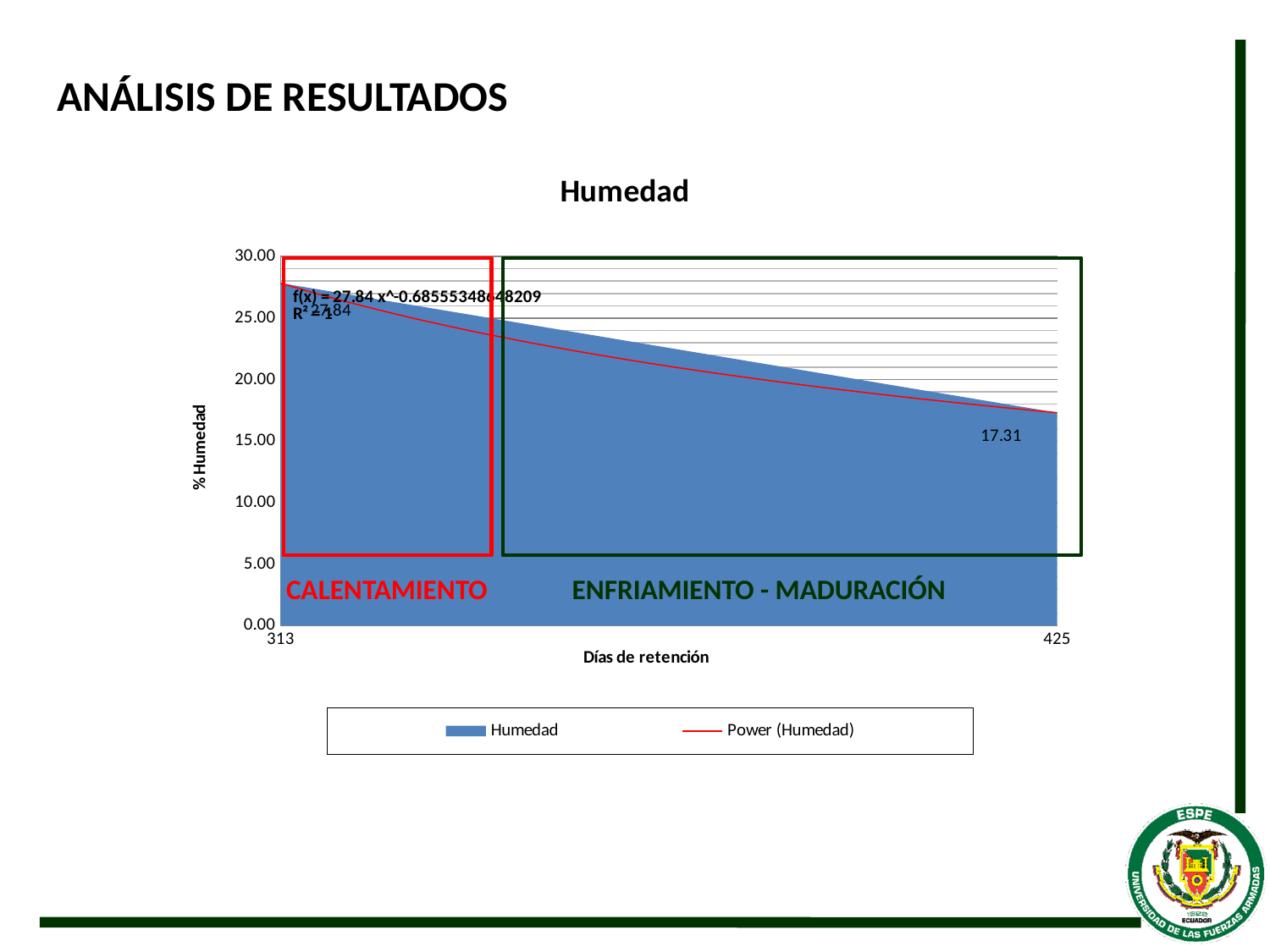
Is the % Humedad value at 425 días de retención greater or less than 20.00? less What is the difference between the % Humedad values at 313 and 425 días de retención? 10.53 What is the % Humedad value at 425 días de retención? 17.31 What is the title of the chart? Humedad Which x-axis category has the highest % Humedad value? 313 How many x-axis categories are labelled on the chart? 2 Does the % Humedad value rise or fall from 313 to 425 días de retención? Fall What is the % Humedad value at 313 días de retención? 27.84 What is the label of the x axis? Días de retención What type of chart is shown on the slide? Area chart Which x-axis category has the lowest % Humedad value? 425 How many entries does the legend list? 2